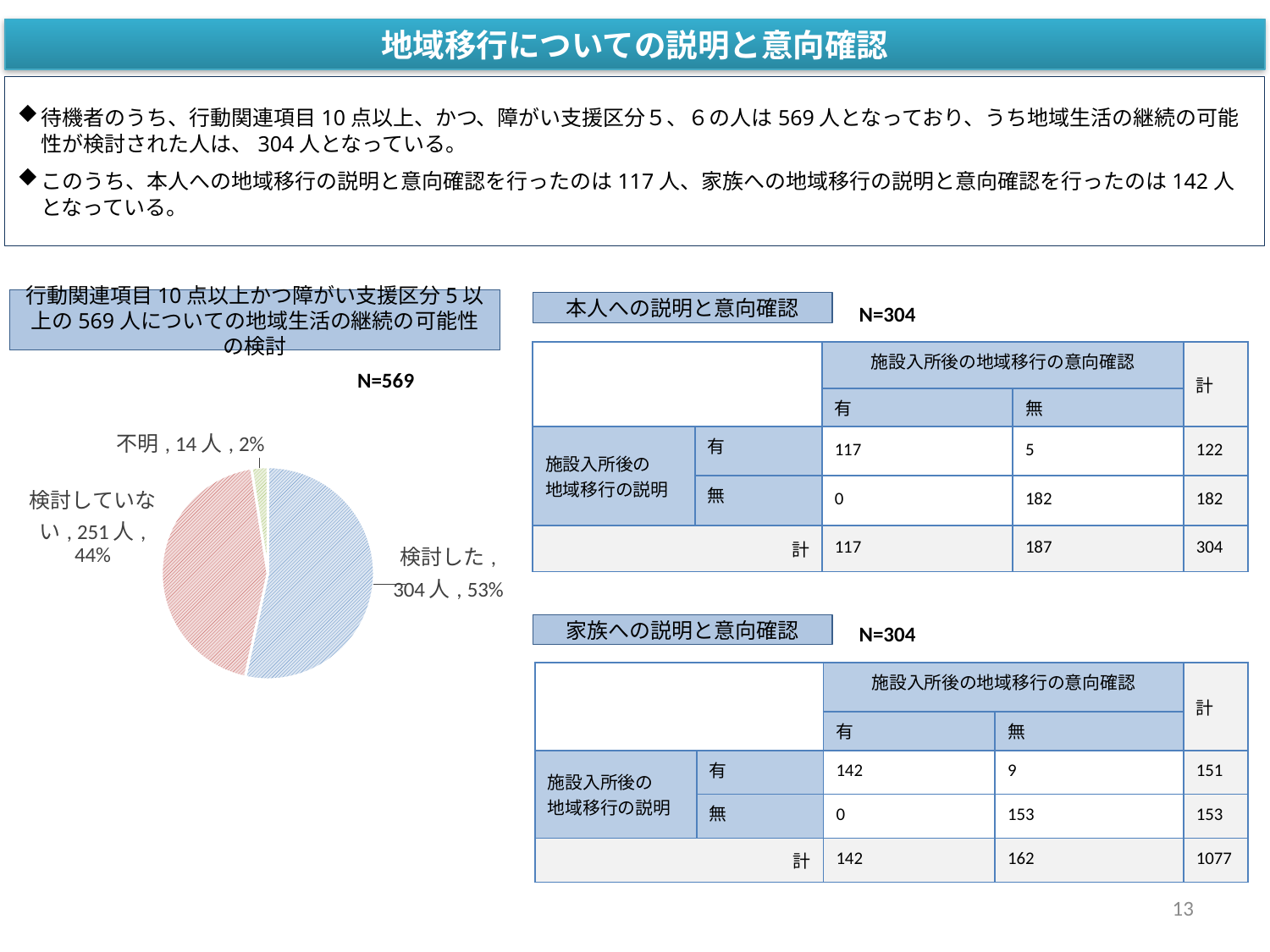
In the pie chart, how many people are in the 検討していない category? 251人 In the pie chart, how many people are in the 不明 category? 14人 What share of the pie does 検討していない represent? 44% What is the N value shown next to the pie chart? N=569 How many slices does the pie chart have? 3 What kind of chart is shown on the left of the slide? pie chart Which category in the pie chart has the smallest number of people? 不明 What share of the pie does 不明 represent? 2% What share of the pie does 検討した represent? 53% What is the difference in people between 検討した and 検討していない in the pie chart? 53人 Which category in the pie chart has the largest number of people? 検討した In the pie chart, how many people are in the 検討した category? 304人